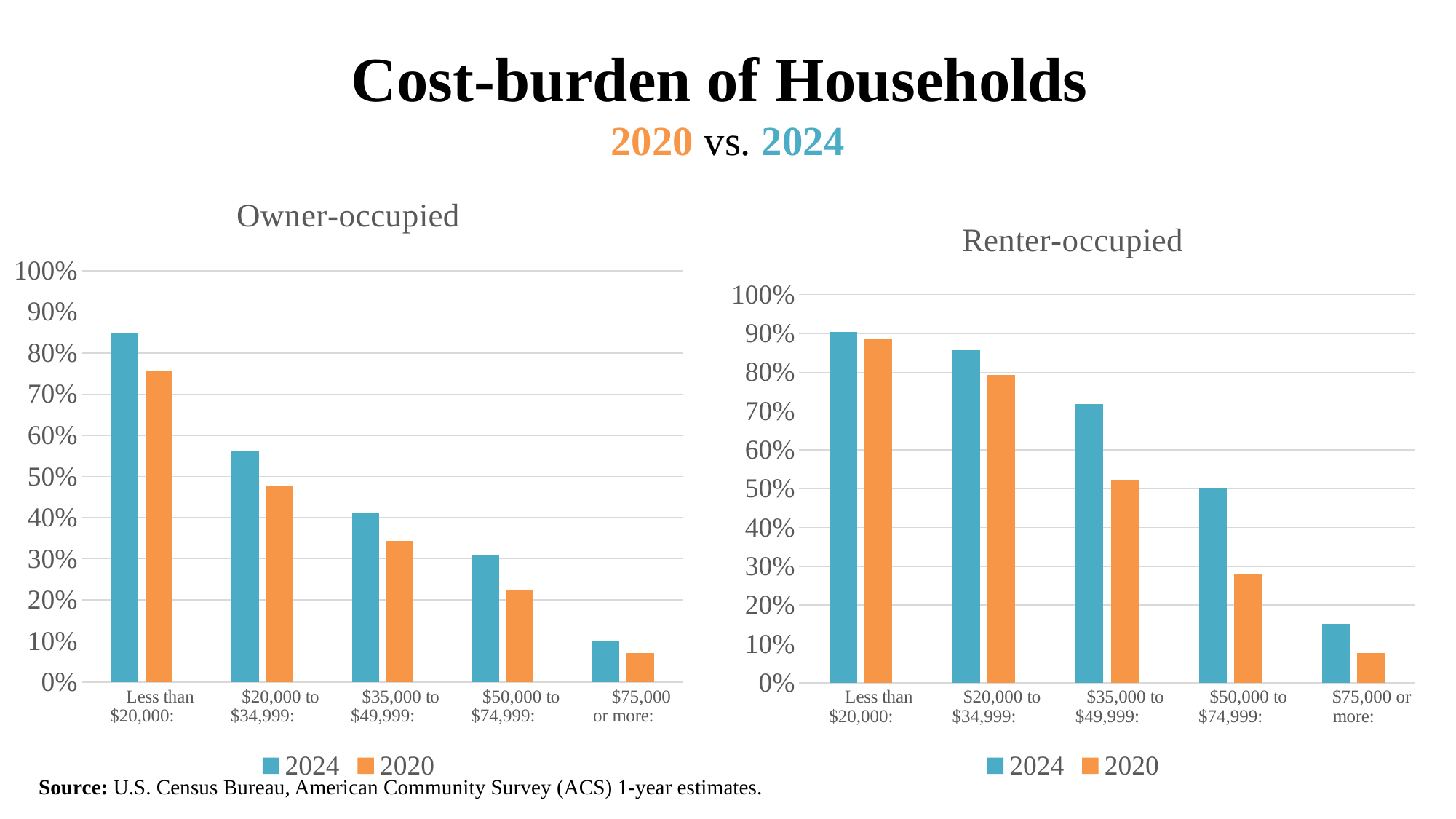
In the Renter-occupied chart, do the 2024 values rise or fall as income increases along the x axis? fall In the Owner-occupied chart, is the 2020 value for $35,000 to $49,999 greater or less than 40%? less How many series does the legend of the Renter-occupied chart list? 2 How many income categories are shown on the x axis of the Owner-occupied chart? 5 In the Renter-occupied chart, is the 2024 value for $20,000 to $34,999 greater or less than 80%? greater In the Owner-occupied chart, which income category has the highest 2024 value? Less than $20,000 In the Owner-occupied chart, is the 2024 value for Less than $20,000 greater or less than 80%? greater Which colour represents 2020 in the legends of both charts? orange In the Owner-occupied chart, which is larger for Less than $20,000: the 2024 value or the 2020 value? 2024 In the Renter-occupied chart, which income category has the lowest 2020 value? $75,000 or more What type of chart is the Owner-occupied chart? bar chart